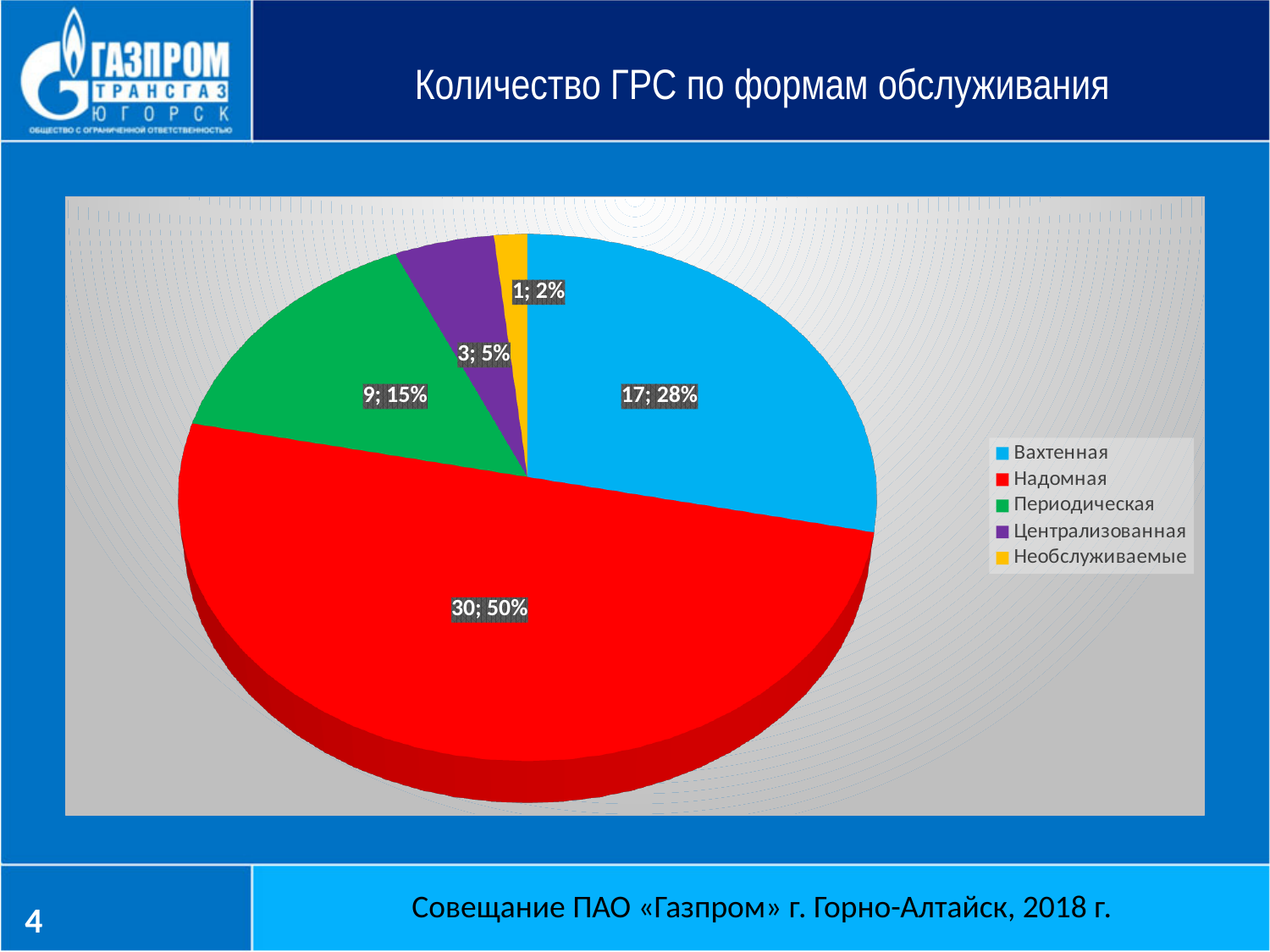
What is the value for Централизованная? 3 What is the value for Периодическая? 9 What is the value for Вахтенная? 17 What kind of chart is shown on the slide? pie chart What is the value for Надомная? 30 Which category has the largest slice of the pie? Надомная What share of the pie does Периодическая represent? 15% How many categories does the pie chart show? 5 Which category has the smallest slice of the pie? Необслуживаемые What share of the pie does Вахтенная represent? 28% What is the title of the chart? Количество ГРС по формам обслуживания What is the difference between the values for Надомная and Вахтенная? 13